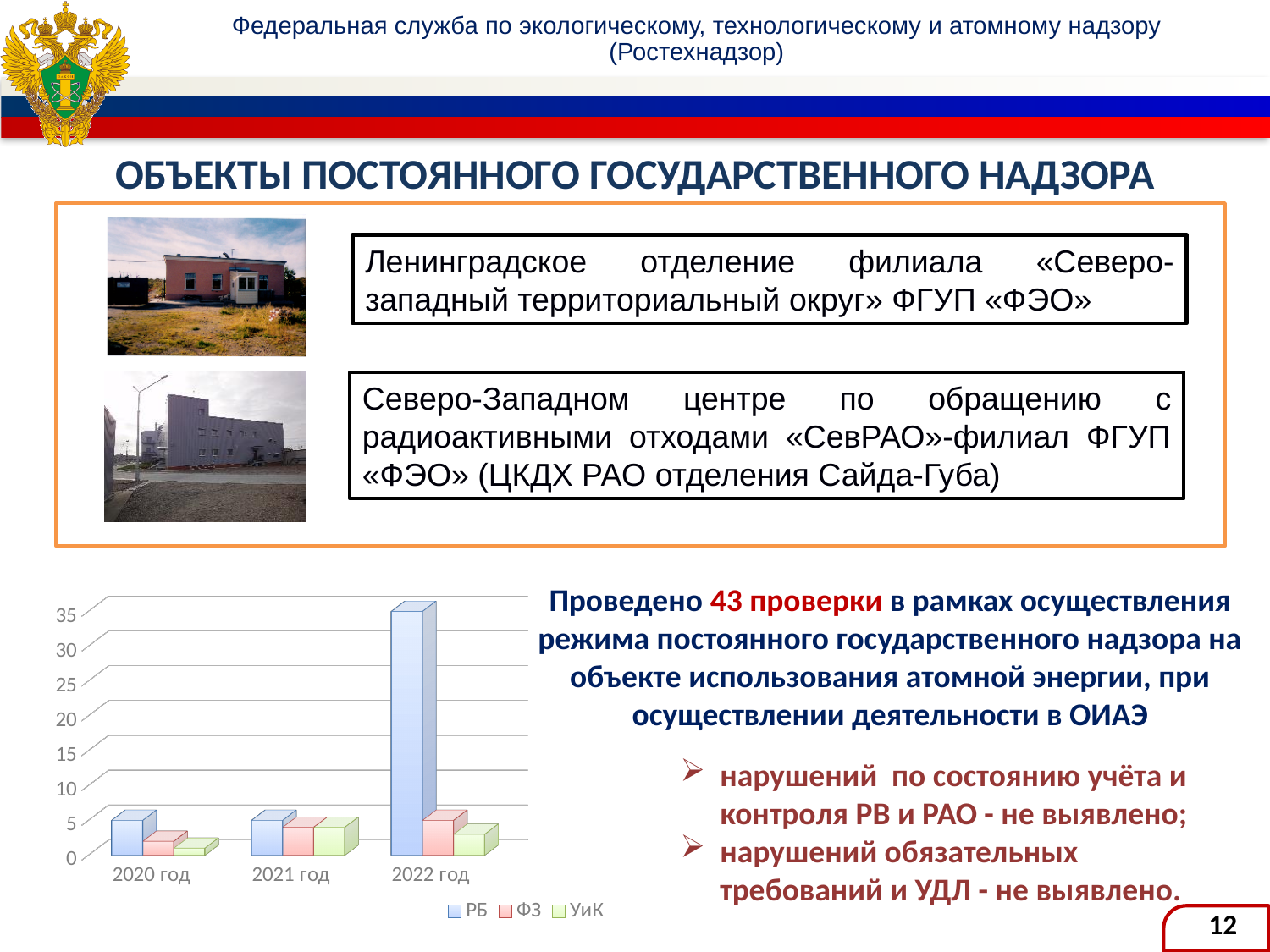
Which is larger in 2020 год: the value for РБ or the value for УиК? РБ Is the value for ФЗ in 2022 год greater or less than 10? less In which year is the value for РБ the highest? 2022 год Is the value for РБ in 2022 год greater or less than 30? greater Is the value for РБ in 2020 год greater or less than 10? less Does the value for РБ rise or fall from 2021 год to 2022 год? rise How many series does the chart legend list? 3 What kind of chart is shown at the bottom left of the slide? bar chart Which is larger in 2022 год: the value for РБ or the value for ФЗ? РБ Which is larger for РБ: the value in 2020 год or the value in 2022 год? 2022 год Which series are listed in the chart legend? РБ, ФЗ, УиК How many year categories are shown on the x axis of the chart? 3